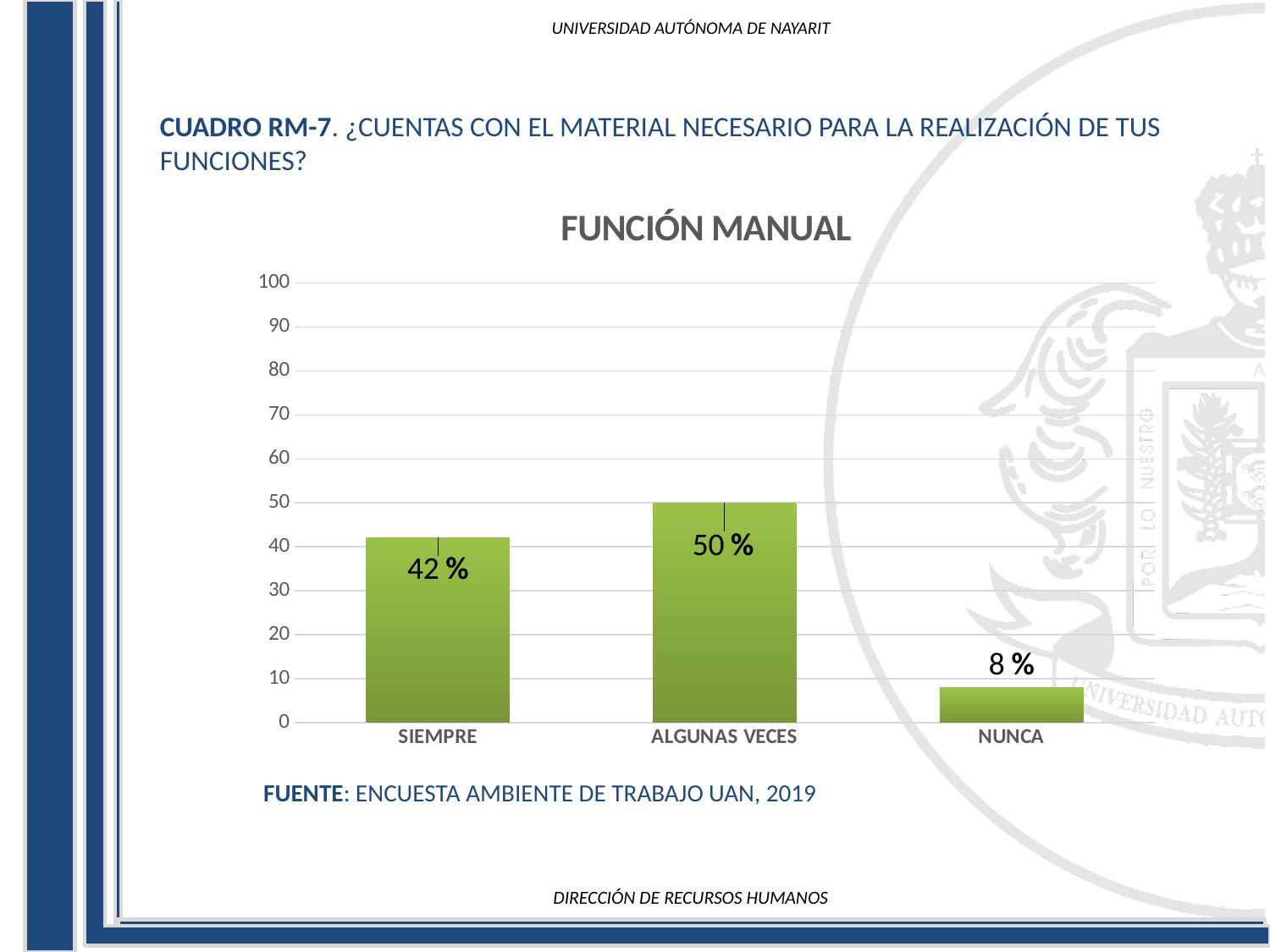
Which category has the lowest value? NUNCA What is the value for NUNCA? 8 % What kind of chart is shown on the slide? bar chart How many categories are shown on the x axis? 3 Is the value for NUNCA greater or less than 10? less What is the difference between the values for ALGUNAS VECES and SIEMPRE? 8 % Which is larger, the value for SIEMPRE or the value for NUNCA? SIEMPRE What is the value for ALGUNAS VECES? 50 % Which category has the highest value? ALGUNAS VECES What is the value for SIEMPRE? 42 % What is the difference between the values for SIEMPRE and NUNCA? 34 % What is the title of the chart? FUNCIÓN MANUAL